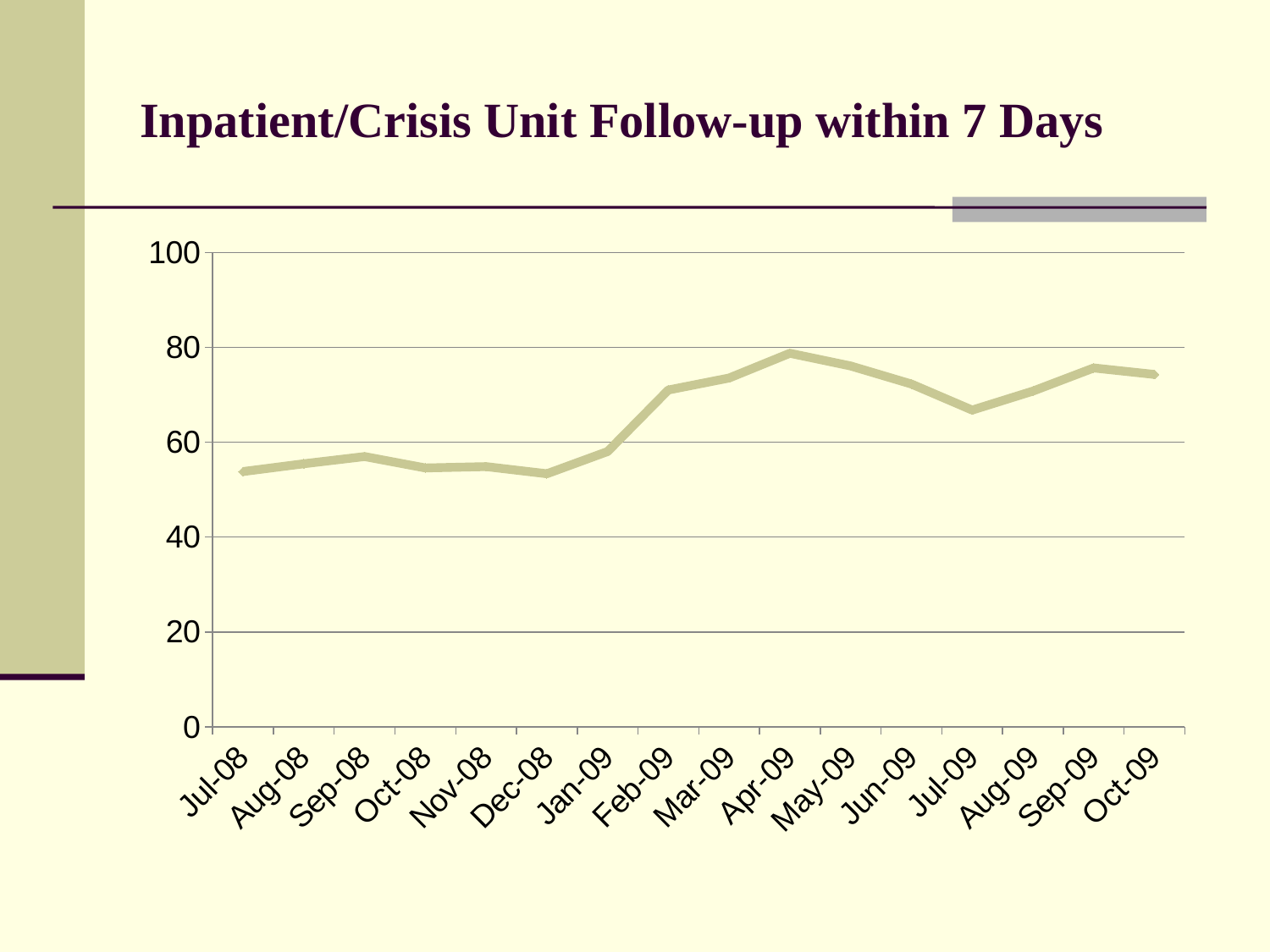
What is the title of the chart? Inpatient/Crisis Unit Follow-up within 7 Days Which is larger, the value for Jan-09 or the value for Feb-09? Feb-09 Which is larger, the value for Jun-09 or the value for Jul-09? Jun-09 Is the value for Jul-08 greater or less than 60? less Which month has the highest value? Apr-09 Overall, do the values rise or fall from Jul-08 to Oct-09? rise How many months are plotted along the x axis? 16 Is the value for Feb-09 greater or less than 60? greater Is the value for Jul-09 greater or less than 60? greater What kind of chart is shown on the slide? line chart